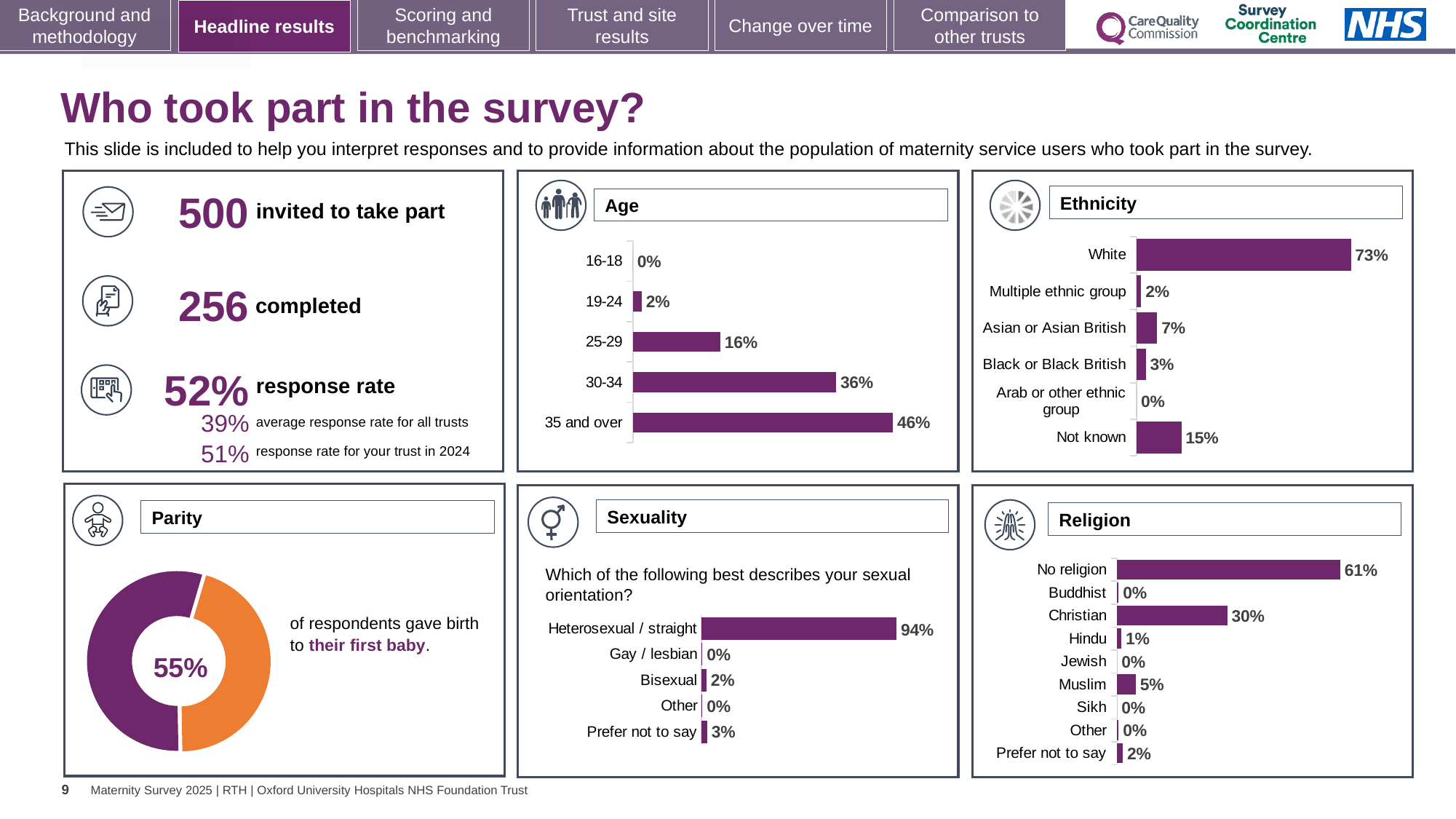
In the Age chart, what is the difference between the 35 and over group and the 25-29 group? 30% In the Age chart, which age group has the highest percentage? 35 and over In the Ethnicity chart, how many categories are shown? 6 In the Sexuality chart, what percentage of respondents answered Prefer not to say? 3% In the Ethnicity chart, which category has the highest percentage? White In the Religion chart, what is the difference between No religion and Christian? 31% In the Religion chart, what percentage of respondents were Christian? 30% What kind of chart is the Parity chart? Doughnut chart In the Religion chart, which is larger, Muslim or Hindu? Muslim In the Sexuality chart, how many categories are shown? 5 In the Age chart, what percentage of respondents were aged 30-34? 36% In the Ethnicity chart, what percentage of respondents were Asian or Asian British? 7%